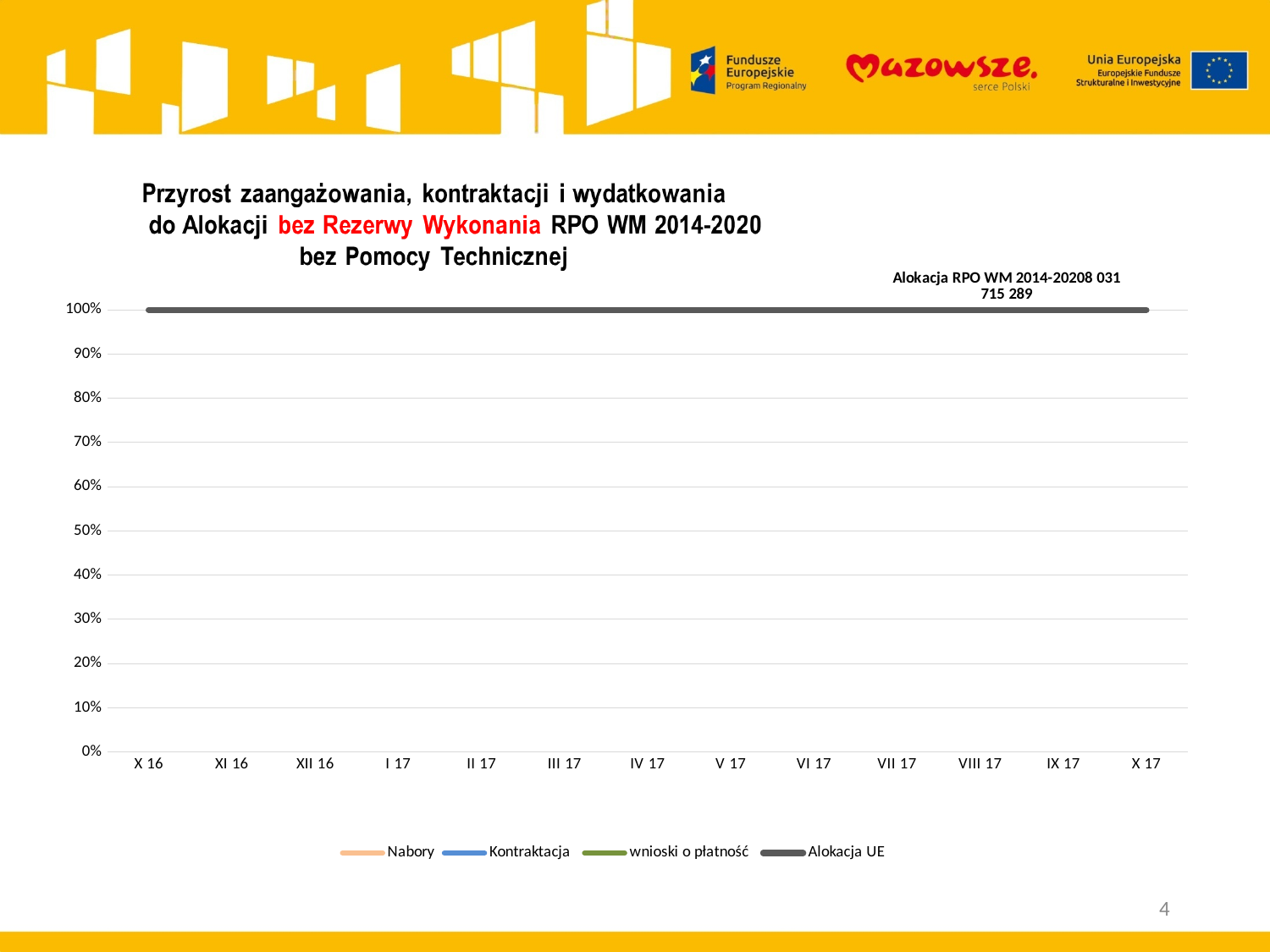
What is the value of the Alokacja UE line at X 17? 100% Is the value of the Alokacja UE line at III 17 greater or less than 90%? greater What is the first category on the x axis? X 16 Does the Alokacja UE line rise, fall or stay flat from X 16 to X 17? stays flat What is the value of the Alokacja UE line at V 17? 100% What kind of chart is shown on the slide? line chart How many series does the legend list? 4 How many categories are shown on the x axis? 13 Which series is listed first in the legend? Nabory What is the value of the Alokacja UE line at X 16? 100%